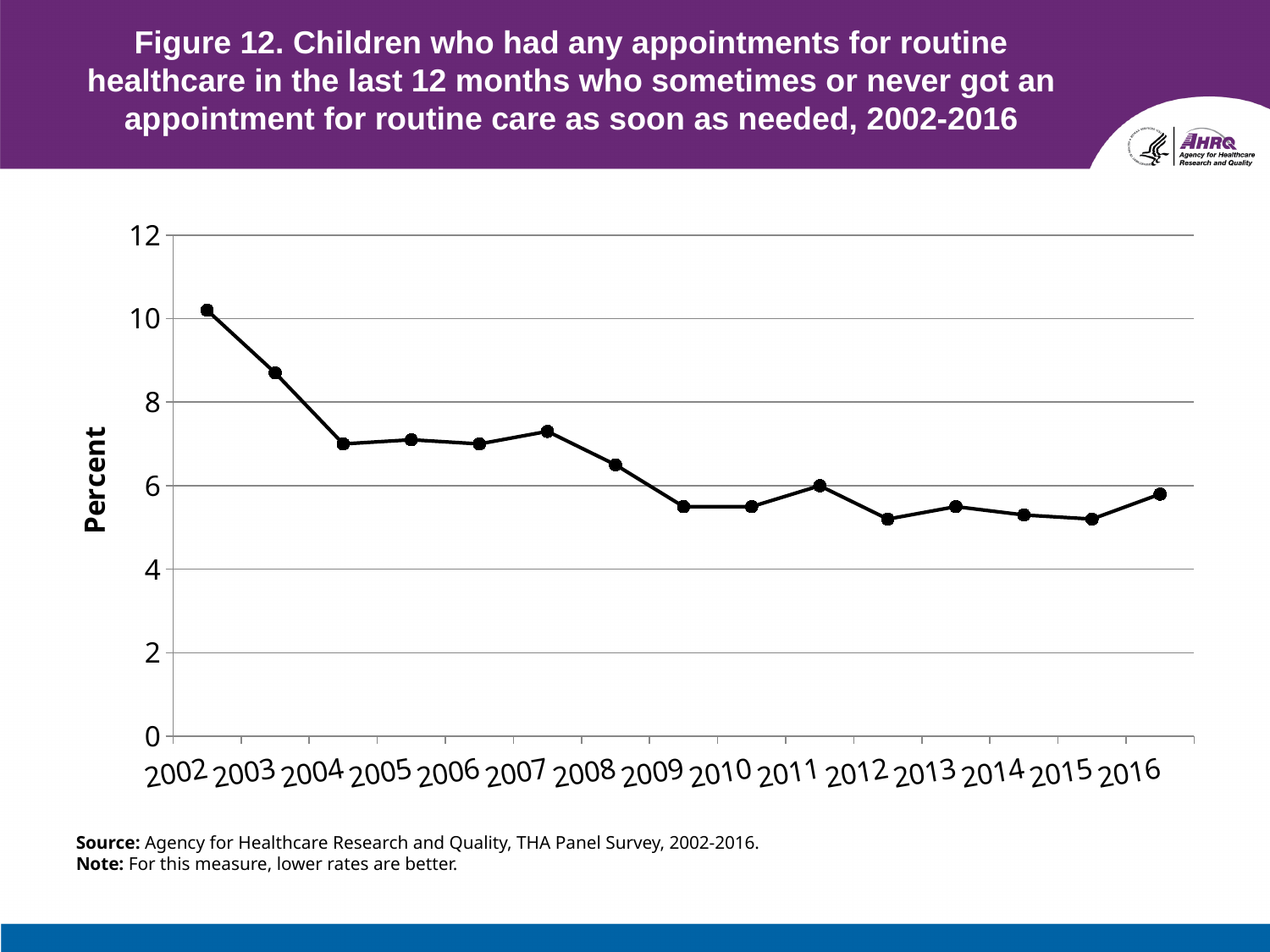
Is the value for 2012 greater or less than 6? less What kind of chart is shown on the slide? line chart Which is larger, the value for 2002 or the value for 2016? 2002 Do the values generally rise or fall from 2002 to 2016? fall Is the value for 2004 greater or less than 8? less Which is larger, the value for 2007 or the value for 2008? 2007 How many years are plotted along the x axis? 15 Is the value for 2003 greater or less than 8? greater Which year has the highest value? 2002 According to the note below the chart, are lower or higher rates better for this measure? lower What is the label on the y axis? Percent